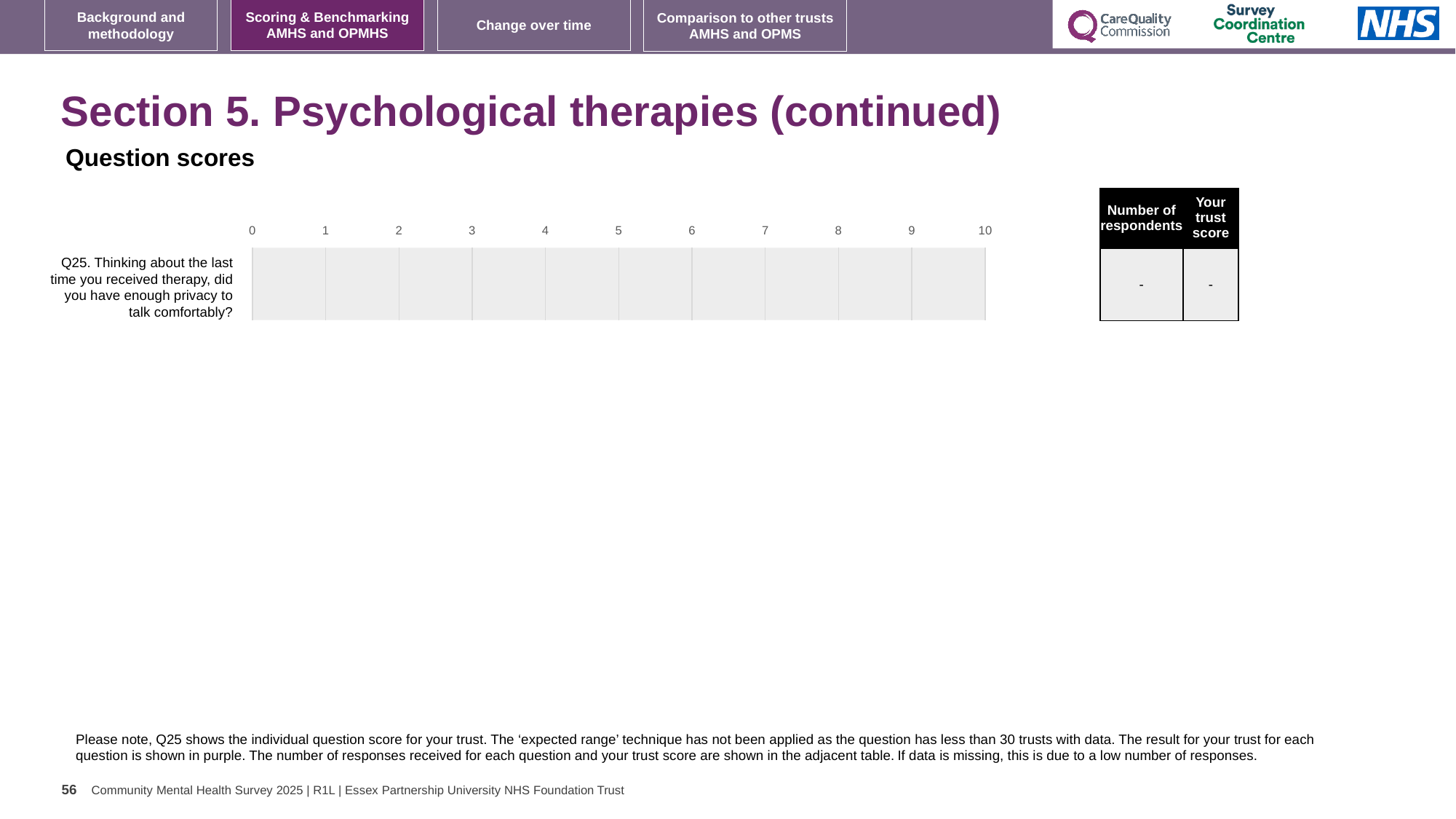
What is the lowest value shown on the chart's horizontal axis? 0 What is shown in the 'Your trust score' column for Q25? - Is a bar plotted for Q25 on the chart? No What is shown in the 'Number of respondents' column for Q25? - How many questions (categories) are plotted on the chart? 1 What is the highest value shown on the chart's horizontal axis? 10 What kind of chart is shown on the slide? bar chart Which question number is the category label on the chart? Q25